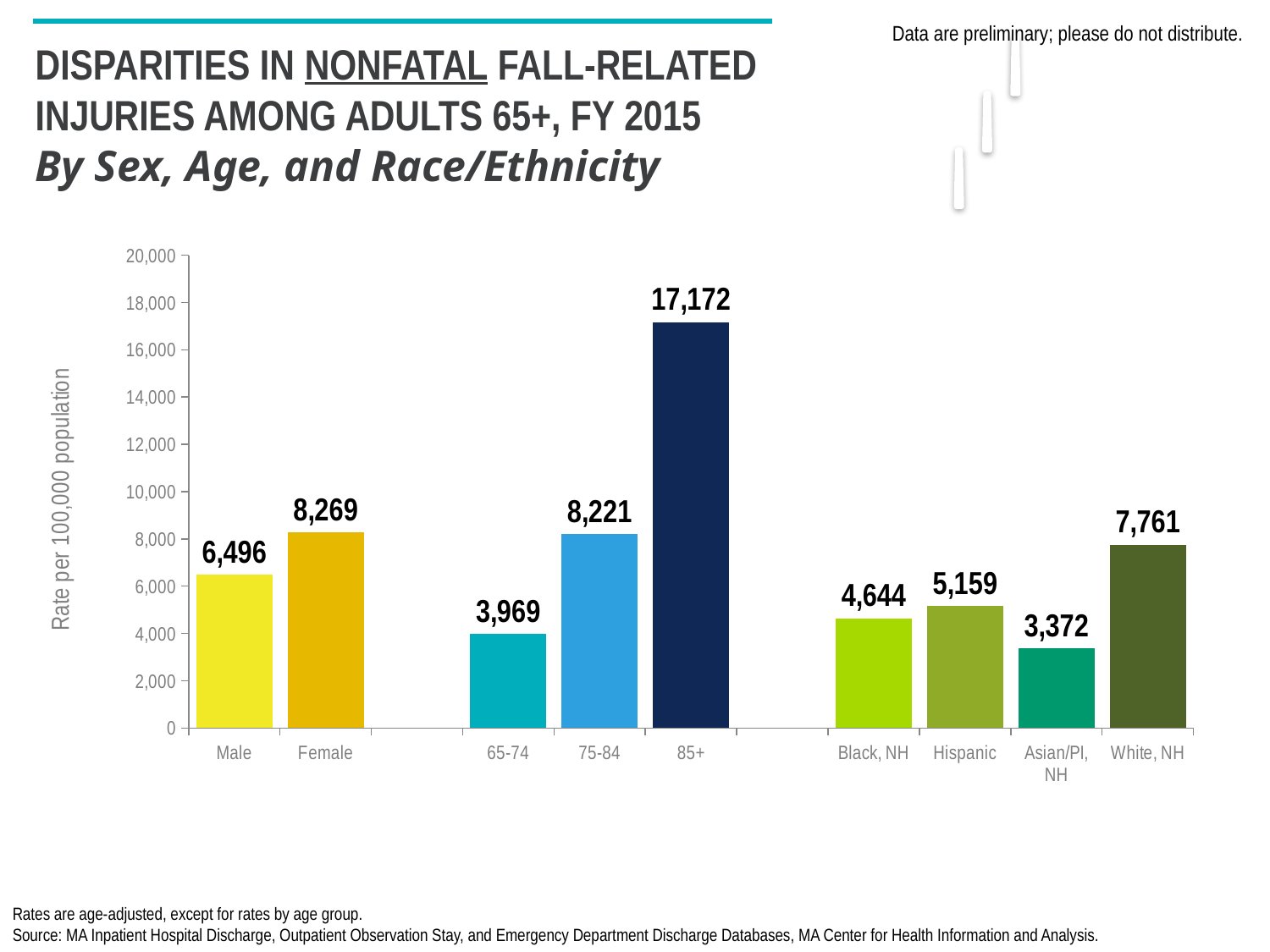
What is the rate of nonfatal fall-related injuries for Female adults 65+? 8,269 What is the difference between the Female and Male rates? 1,773 Which category has the highest rate on the chart? 85+ Which has a higher rate, Hispanic or Black, NH? Hispanic What is the rate for the 85+ age group? 17,172 What is the difference between the rates for White, NH and Black, NH? 3,117 Is the rate for the 75-84 age group greater or less than 10,000? less What is the rate for Asian/PI, NH adults? 3,372 What kind of chart is shown on the slide? bar chart How many categories are plotted on the chart? 9 What is the label of the vertical axis? Rate per 100,000 population Which category has the lowest rate on the chart? Asian/PI, NH